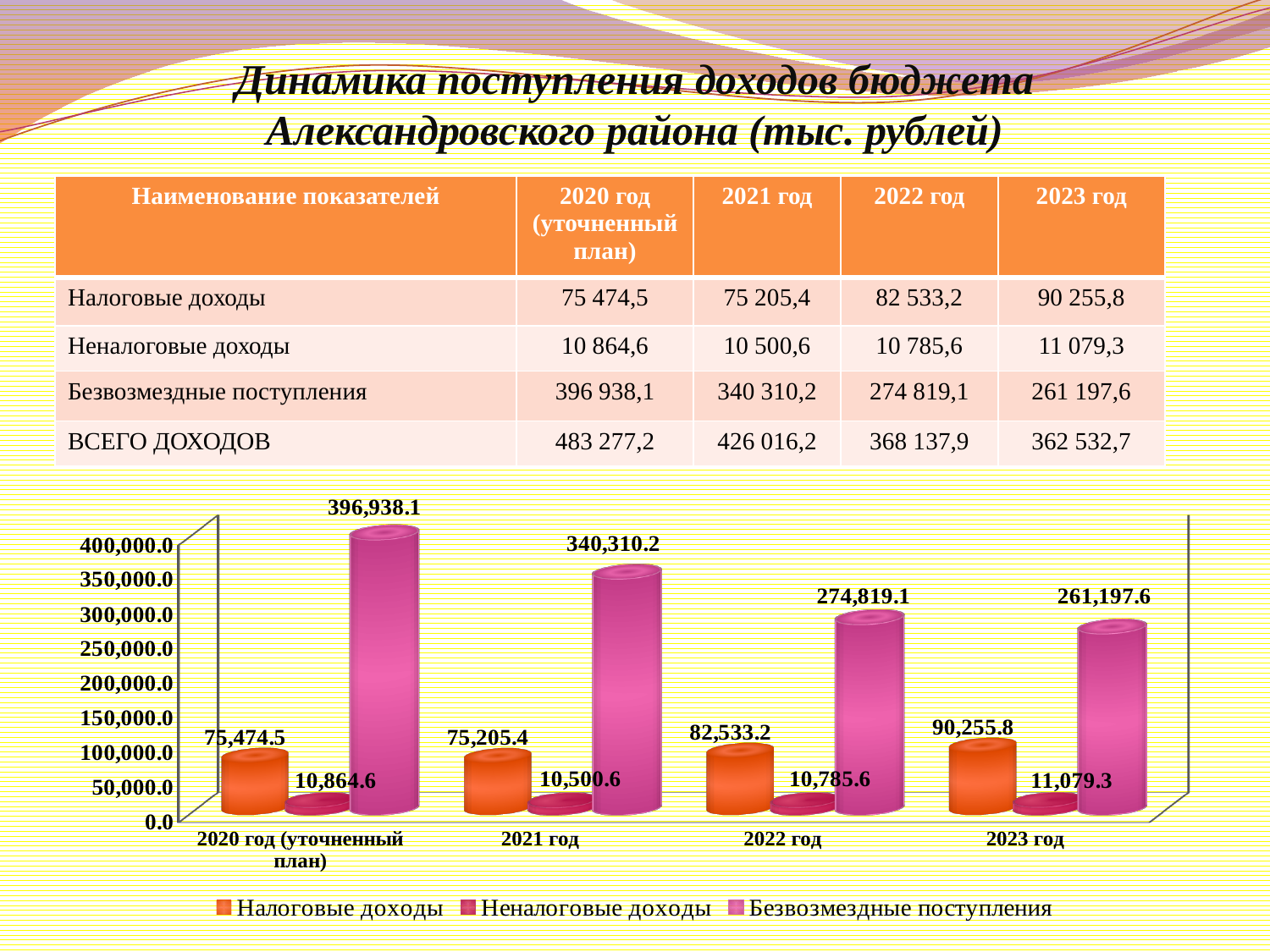
Which is larger in the chart: Налоговые доходы for 2022 год or for 2023 год? 2023 год Is the value of Безвозмездные поступления for 2023 год greater or less than 300,000.0? less How many series does the chart legend list? 3 What is the difference between Безвозмездные поступления in 2022 год and 2023 год in the chart? 13,621.5 Does Безвозмездные поступления rise or fall from 2020 год (уточненный план) to 2023 год in the chart? fall What is the value of Безвозмездные поступления for 2021 год in the chart? 340,310.2 What is the value of Налоговые доходы for 2023 год in the chart? 90,255.8 In which year is Безвозмездные поступления highest in the chart? 2020 год (уточненный план) In which year is Налоговые доходы lowest in the chart? 2021 год How many year categories are shown on the x axis of the chart? 4 What kind of chart is shown on the slide? bar chart What is the value of Неналоговые доходы for 2020 год (уточненный план) in the chart? 10,864.6